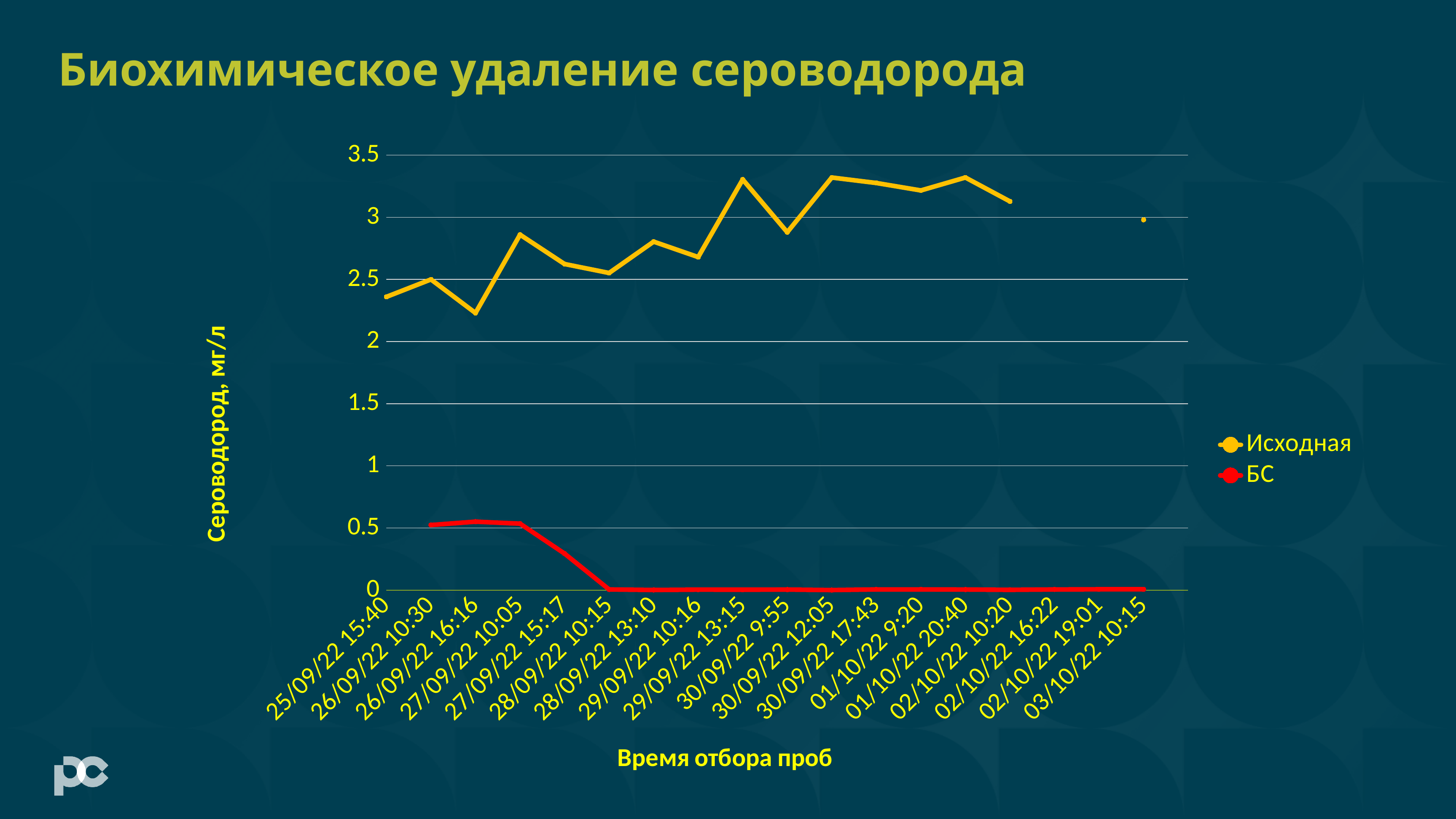
Does the БС series rise or fall over the sampling period? fall What is the title of the slide? Биохимическое удаление сероводорода Is the value of Исходная at 25/09/22 15:40 greater or less than 2.5? less How many sampling times are shown on the x axis? 18 At which sampling time is the Исходная series lowest? 26/09/22 16:16 How many series does the legend list? 2 Is the value of Исходная at 27/09/22 10:05 greater or less than 2.5? greater What is the label of the y axis? Сероводород, мг/л At 27/09/22 10:05, which series has the larger value, Исходная or БС? Исходная What kind of chart is shown on the slide? line chart Is the value of БС at 28/09/22 10:15 greater or less than 0.5? less